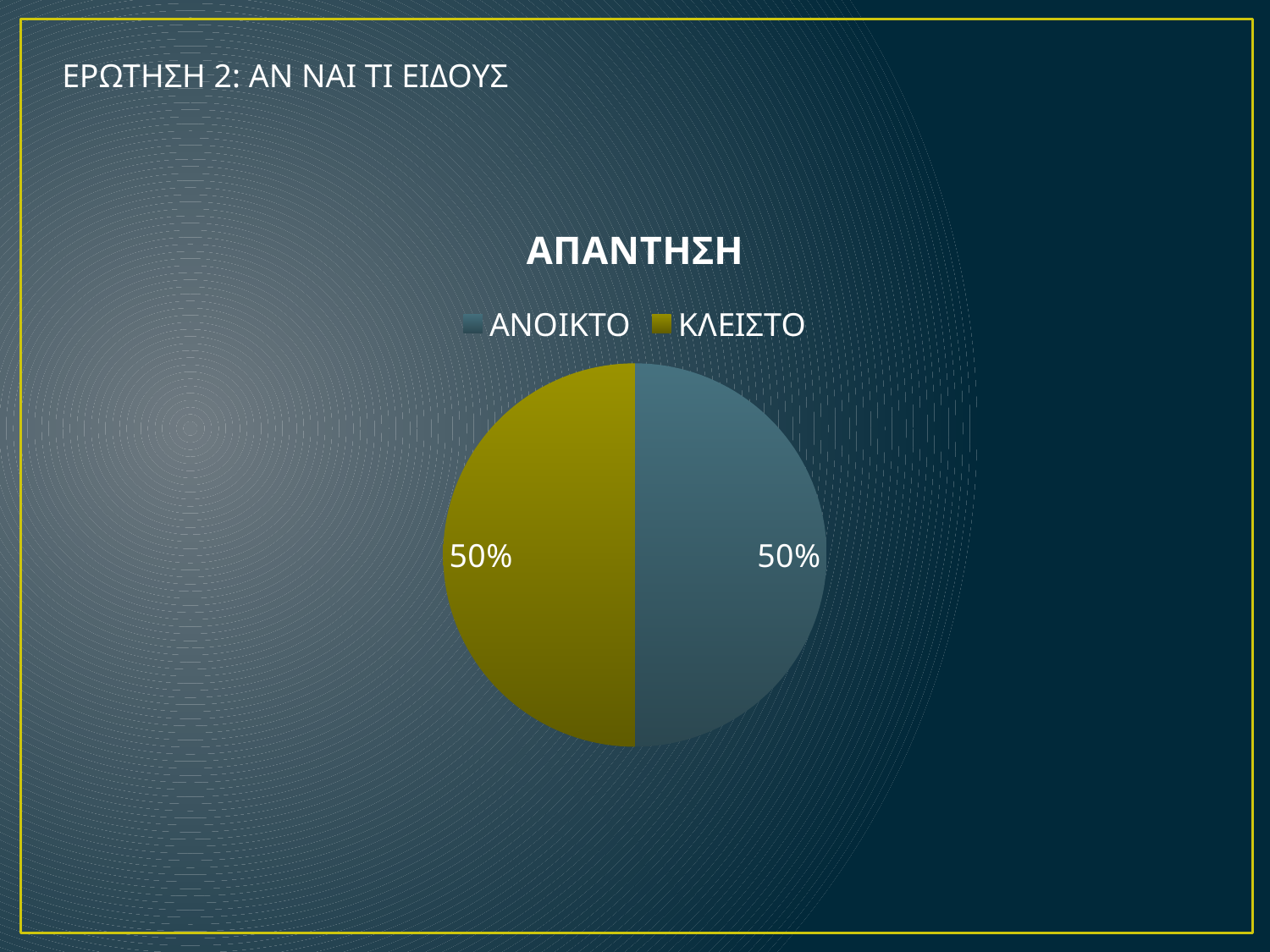
How many slices does the pie chart have? 2 What is the difference between the shares of ΑΝΟΙΚΤΟ and ΚΛΕΙΣΤΟ? 0% What is the title of the chart? ΑΠΑΝΤΗΣΗ What share of the pie does ΑΝΟΙΚΤΟ represent? 50% What is the combined share of ΑΝΟΙΚΤΟ and ΚΛΕΙΣΤΟ? 100% How many entries does the legend list? 2 Which legend entry is shown in yellow? ΚΛΕΙΣΤΟ What kind of chart is shown on the slide? pie chart What share of the pie does ΚΛΕΙΣΤΟ represent? 50%